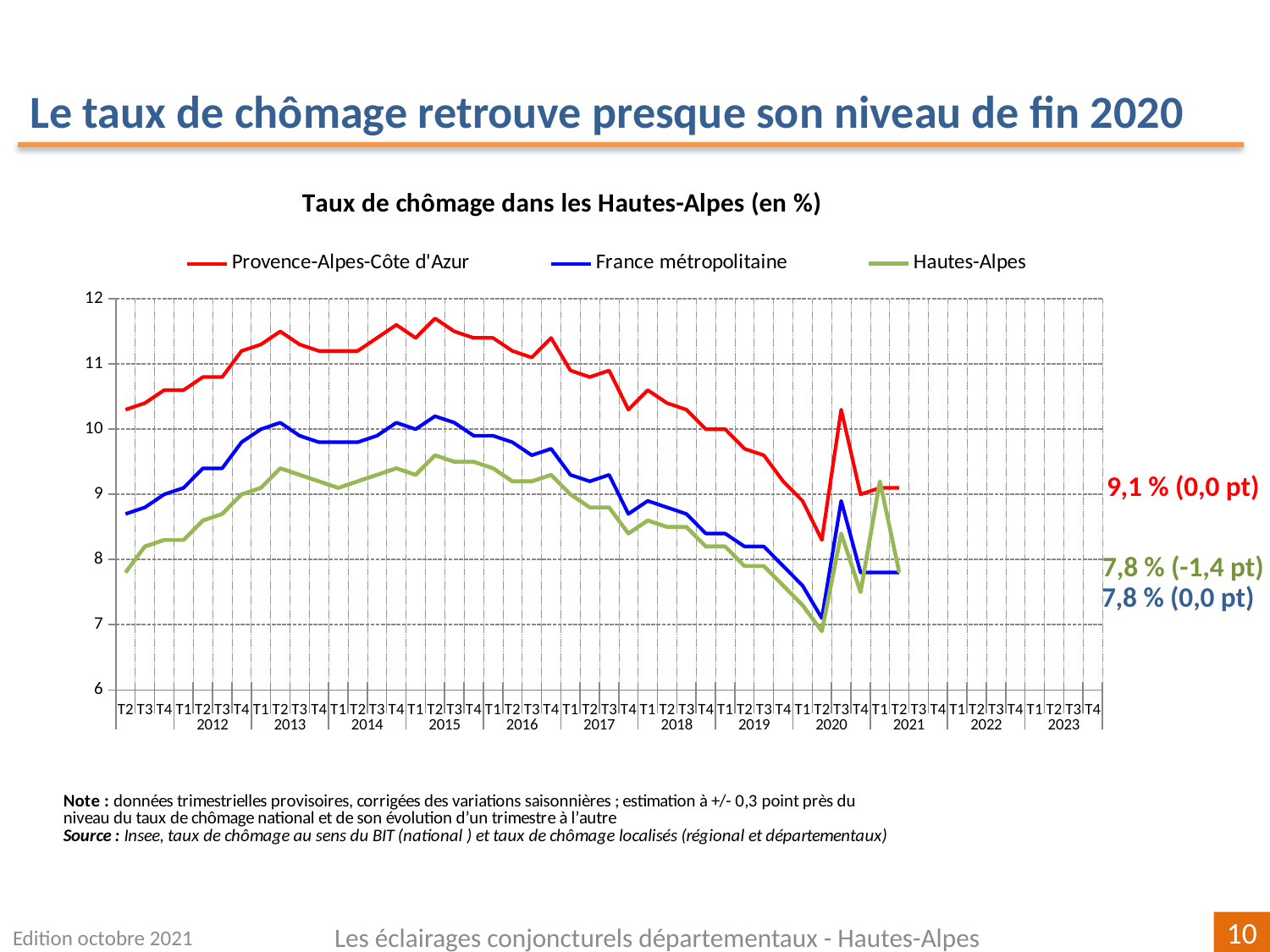
Does the Provence-Alpes-Côte d'Azur line rise or fall between 2015 and 2019? fall What is the latest unemployment rate shown for Hautes-Alpes? 7,8 % What kind of chart is shown on the slide? line chart How many series does the legend of the chart list? 3 What is the latest unemployment rate shown for Provence-Alpes-Côte d'Azur? 9,1 % What is the difference between the latest values for Provence-Alpes-Côte d'Azur and Hautes-Alpes? 1,3 points What is the latest unemployment rate shown for France métropolitaine? 7,8 % What quarterly change in points is shown next to the latest Hautes-Alpes value? -1,4 pt What is the title of the chart? Taux de chômage dans les Hautes-Alpes (en %) Is the value for Provence-Alpes-Côte d'Azur in T2 2015 greater or less than 11? greater What colour is the line for Hautes-Alpes? green At the latest point, which series has the highest value? Provence-Alpes-Côte d'Azur